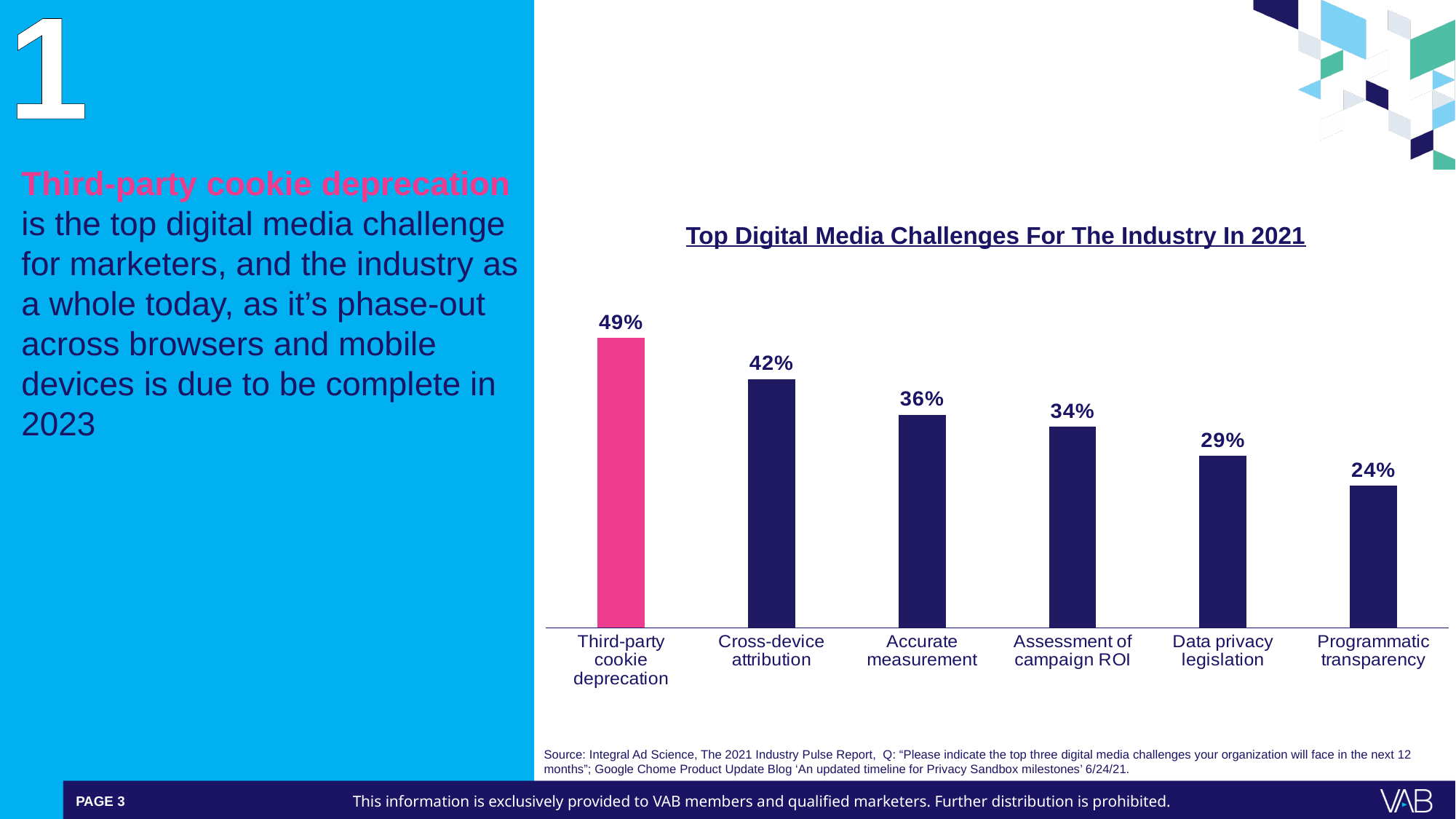
What is the value for Programmatic transparency? 24% How many categories are shown in the chart? 6 What is the difference between the values for Third-party cookie deprecation and Cross-device attribution? 7% Which category has the highest value? Third-party cookie deprecation What is the value for Cross-device attribution? 42% What is the value for Data privacy legislation? 29% What is the title of the chart? Top Digital Media Challenges For The Industry In 2021 What is the difference between the values for Accurate measurement and Assessment of campaign ROI? 2% Which category has the lowest value? Programmatic transparency Which is larger, the value for Accurate measurement or the value for Data privacy legislation? Accurate measurement What kind of chart is shown on the slide? Bar chart What is the value for Third-party cookie deprecation? 49%